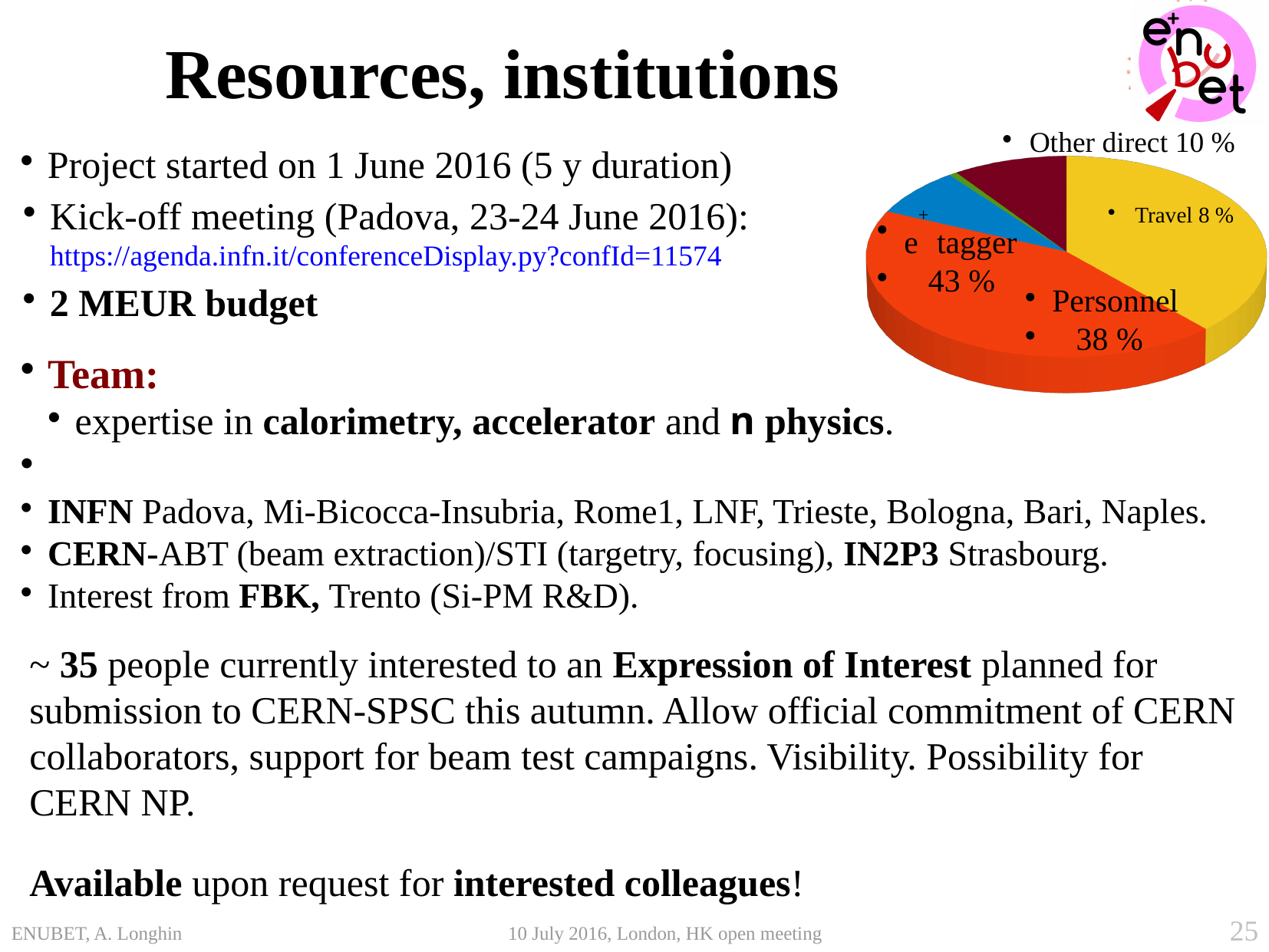
What percentage is shown for Travel in the pie chart? 8 % By how many percentage points does the e+ tagger share exceed the Personnel share? 5 % What share of the budget does the e+ tagger slice represent in the pie chart? 43 % What is the combined share of Personnel and Travel in the pie chart? 46 % What kind of chart is shown on the slide? pie chart Which labelled slice of the pie chart is the largest? e+ tagger What percentage is shown for Personnel in the pie chart? 38 % What percentage is shown for Other direct in the pie chart? 10 % Which is larger in the pie chart, Other direct or Travel? Other direct Which labelled slice of the pie chart is the smallest? Travel